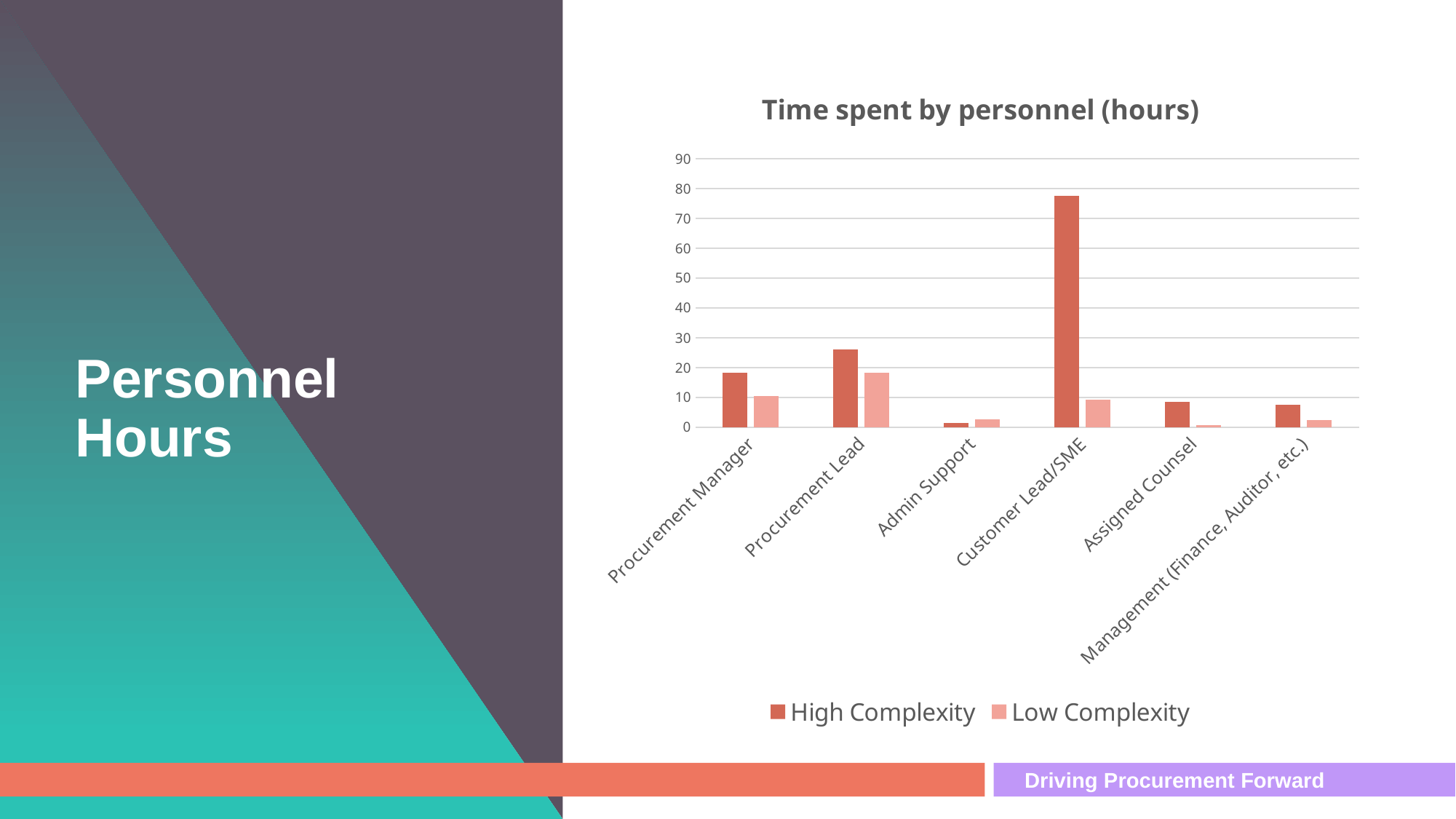
Which is larger: the High Complexity value for Procurement Lead or for Procurement Manager? Procurement Lead How many series does the legend list? 2 What is the title of the chart? Time spent by personnel (hours) Is the High Complexity value for Customer Lead/SME greater or less than 70? greater Which category has the lowest Low Complexity value? Assigned Counsel Is the High Complexity value for Procurement Lead greater or less than 30? less How many personnel categories are shown on the x axis? 6 Which category has the lowest High Complexity value? Admin Support Which category has the highest High Complexity value? Customer Lead/SME For Admin Support, which is larger: the High Complexity value or the Low Complexity value? Low Complexity What kind of chart is shown on the slide? Bar chart Which category has the highest Low Complexity value? Procurement Lead